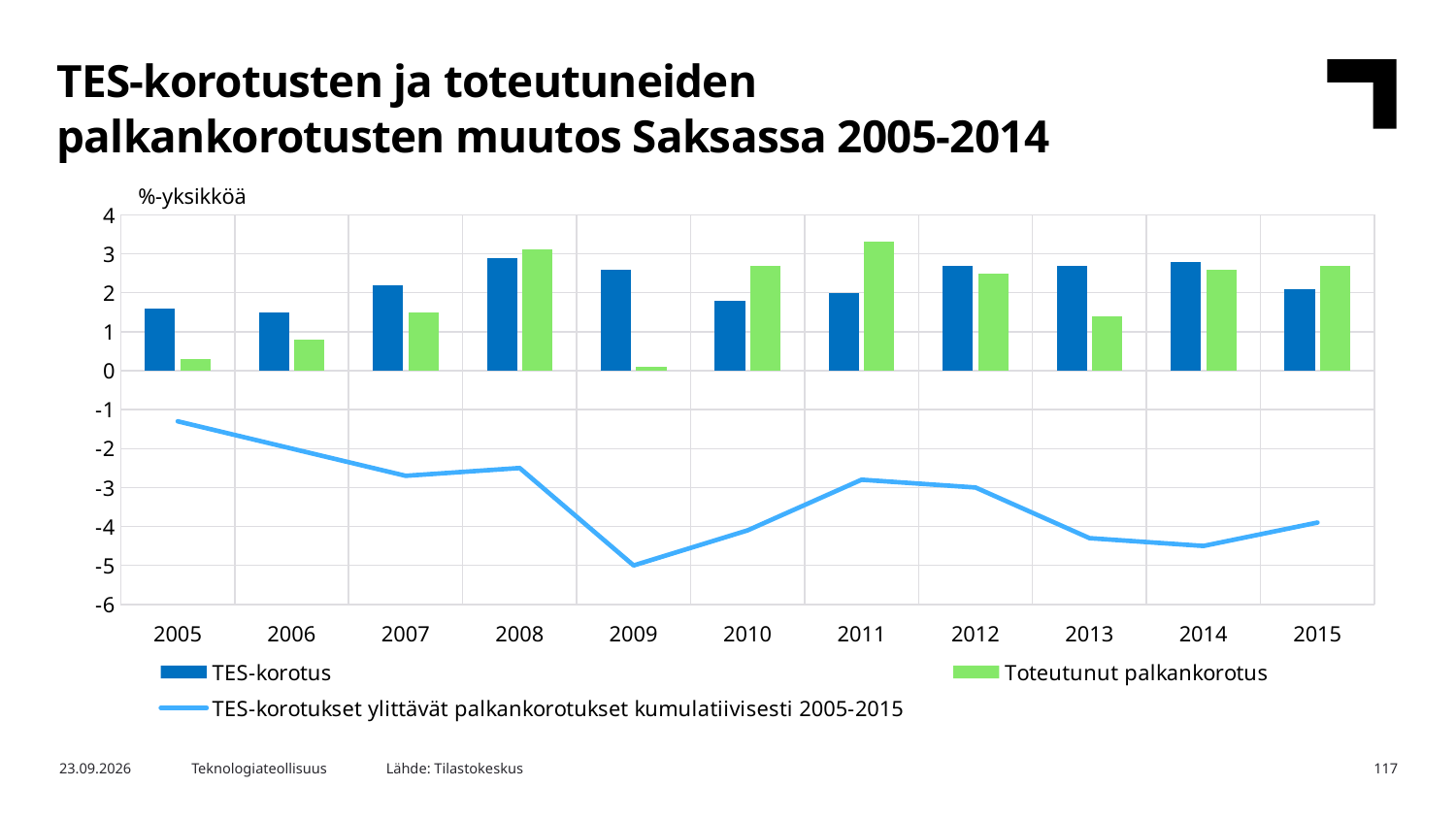
What kind of chart is this? Bar chart combined with a line Is the value of the cumulative line in 2009 greater or less than -4? less In 2013, which is larger: TES-korotus or Toteutunut palkankorotus? TES-korotus Does the cumulative line rise or fall from 2005 to 2009? Falls How many years are shown on the x axis? 11 Is the value for Toteutunut palkankorotus in 2005 greater or less than 1? less How many series does the legend list? 3 Which year has the lowest value for Toteutunut palkankorotus? 2009 In 2010, which is larger: TES-korotus or Toteutunut palkankorotus? Toteutunut palkankorotus In which year does the line TES-korotukset ylittävät palkankorotukset kumulatiivisesti 2005-2015 reach its lowest point? 2009 In which year is the line TES-korotukset ylittävät palkankorotukset kumulatiivisesti 2005-2015 at its highest? 2005